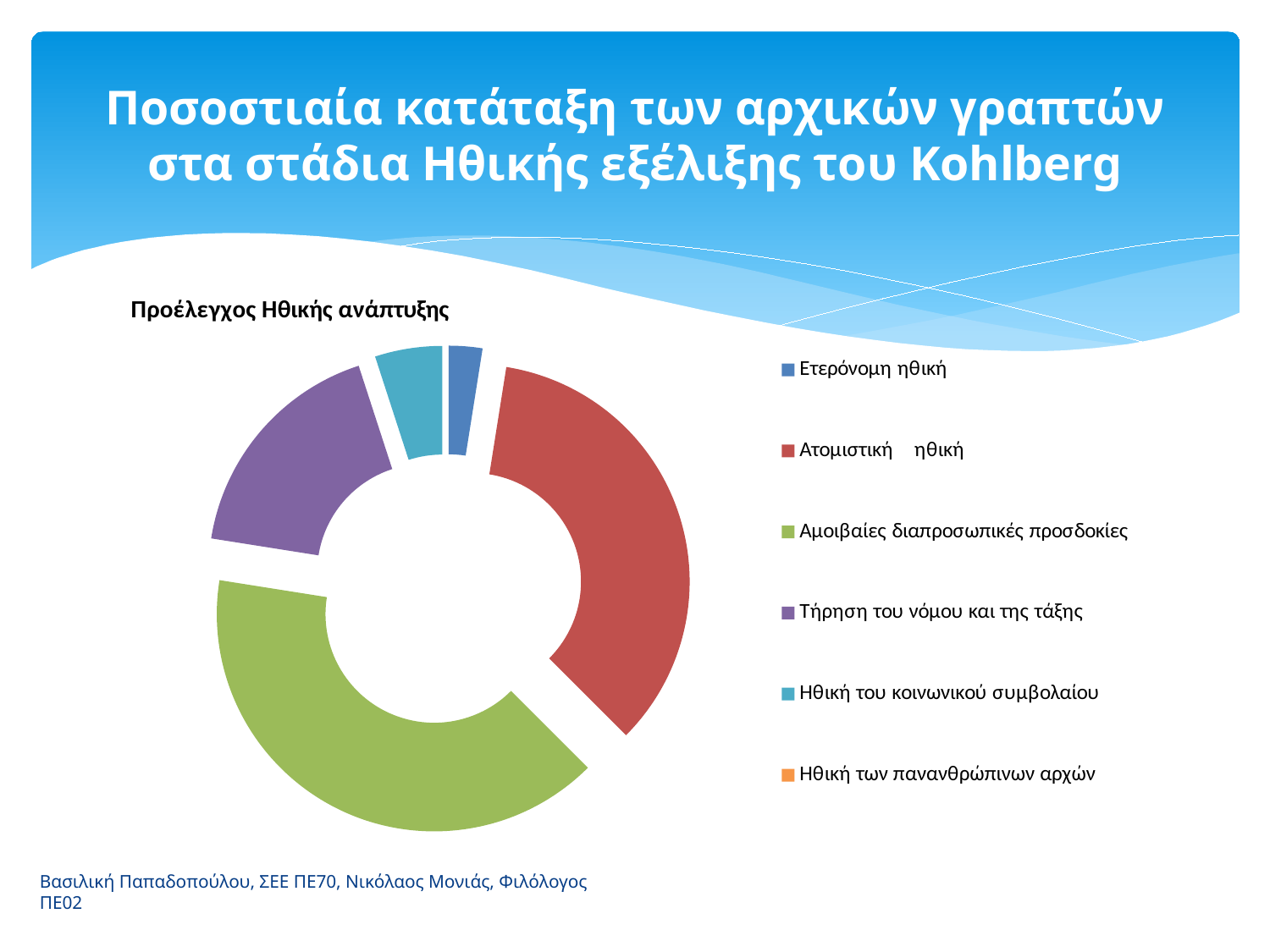
Which category has the largest slice in the chart? Αμοιβαίες διαπροσωπικές προσδοκίες What is the title of the chart? Προέλεγχος Ηθικής ανάπτυξης What colour represents Αμοιβαίες διαπροσωπικές προσδοκίες in the chart? Green Which slice is larger: Τήρηση του νόμου και της τάξης or Ηθική του κοινωνικού συμβολαίου? Τήρηση του νόμου και της τάξης Which slice is larger: Ατομιστική ηθική or Τήρηση του νόμου και της τάξης? Ατομιστική ηθική How many categories does the chart legend list? 6 Which slice is larger: Αμοιβαίες διαπροσωπικές προσδοκίες or Ατομιστική ηθική? Αμοιβαίες διαπροσωπικές προσδοκίες Which category is the second largest slice in the chart? Ατομιστική ηθική What kind of chart is shown on the slide? Doughnut (pie) chart